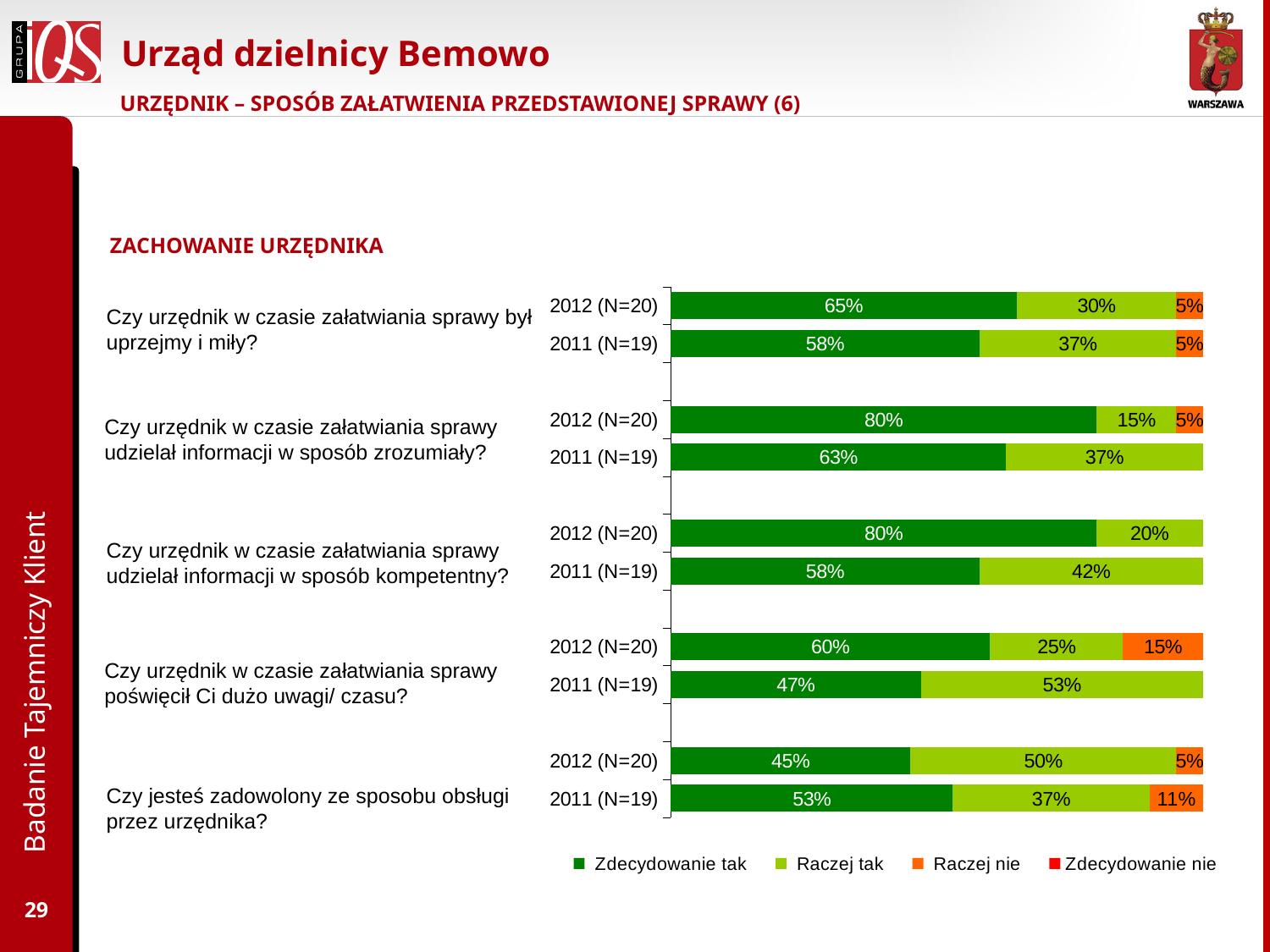
What is the 'Raczej nie' value for 2012 (N=20) for the question 'Czy urzędnik w czasie załatwiania sprawy poświęcił Ci dużo uwagi/ czasu?' 15% How many bars are plotted in the chart? 10 What is the title of the section above the chart? ZACHOWANIE URZĘDNIKA Which bar has the highest 'Zdecydowanie tak' value? 80% (2012 for 'udzielał informacji w sposób zrozumiały' and 'w sposób kompetentny') What is the 'Raczej tak' value for 2011 (N=19) for the question 'Czy urzędnik w czasie załatwiania sprawy udzielał informacji w sposób zrozumiały?' 37% How many series does the legend list? 4 What type of chart is shown on the slide? Stacked bar chart For the question 'Czy jesteś zadowolony ze sposobu obsługi przez urzędnika?', which year has the larger 'Zdecydowanie tak' value, 2012 (N=20) or 2011 (N=19)? 2011 (N=19) What is the 'Raczej nie' value for 2011 (N=19) for the question 'Czy jesteś zadowolony ze sposobu obsługi przez urzędnika?' 11% For the question 'Czy urzędnik w czasie załatwiania sprawy udzielał informacji w sposób kompetentny?', what is the difference in 'Zdecydowanie tak' between 2012 (N=20) and 2011 (N=19)? 22 percentage points Which bar has the lowest 'Zdecydowanie tak' value? 2012 (N=20) for 'Czy jesteś zadowolony ze sposobu obsługi przez urzędnika?' (45%) What is the 'Zdecydowanie tak' value for 2012 (N=20) for the question 'Czy urzędnik w czasie załatwiania sprawy był uprzejmy i miły?' 65%